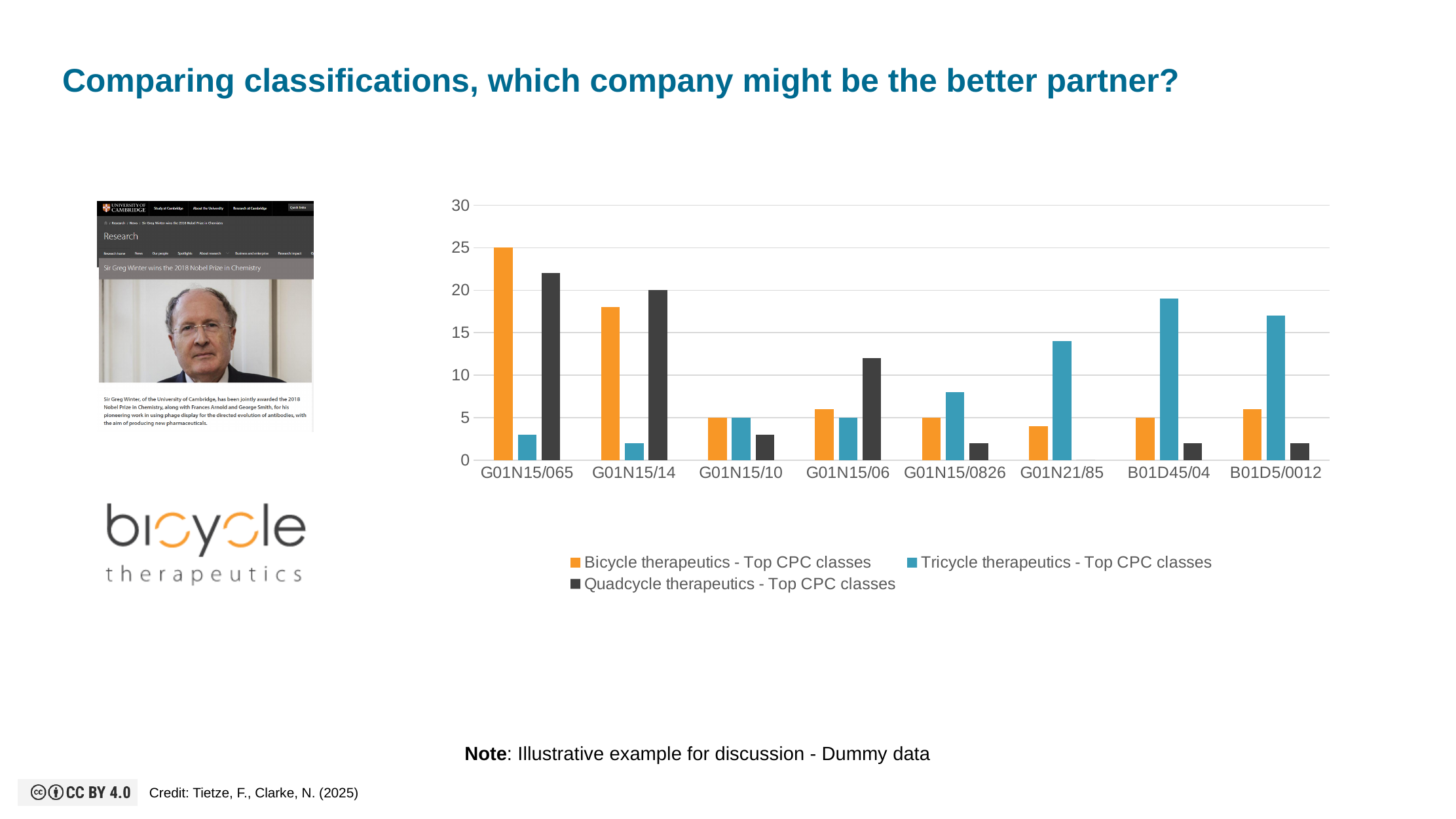
What is the value for Bicycle therapeutics in class G01N15/065? 25 Is the value for Tricycle therapeutics in class G01N15/14 greater or less than 5? less Which CPC class has the highest value for Tricycle therapeutics? B01D45/04 Which colour represents Quadcycle therapeutics in the chart legend? dark grey In class G01N21/85, which series has the larger value, Bicycle therapeutics or Tricycle therapeutics? Tricycle therapeutics Is the value for Quadcycle therapeutics in class G01N15/06 greater or less than 10? greater What is the value for Bicycle therapeutics in class G01N15/10? 5 What kind of chart is shown on the slide? bar chart How many CPC classes are shown on the x axis of the chart? 8 Which CPC class has the highest value for Bicycle therapeutics? G01N15/065 How many series does the chart legend list? 3 What is the value for Quadcycle therapeutics in class G01N15/14? 20